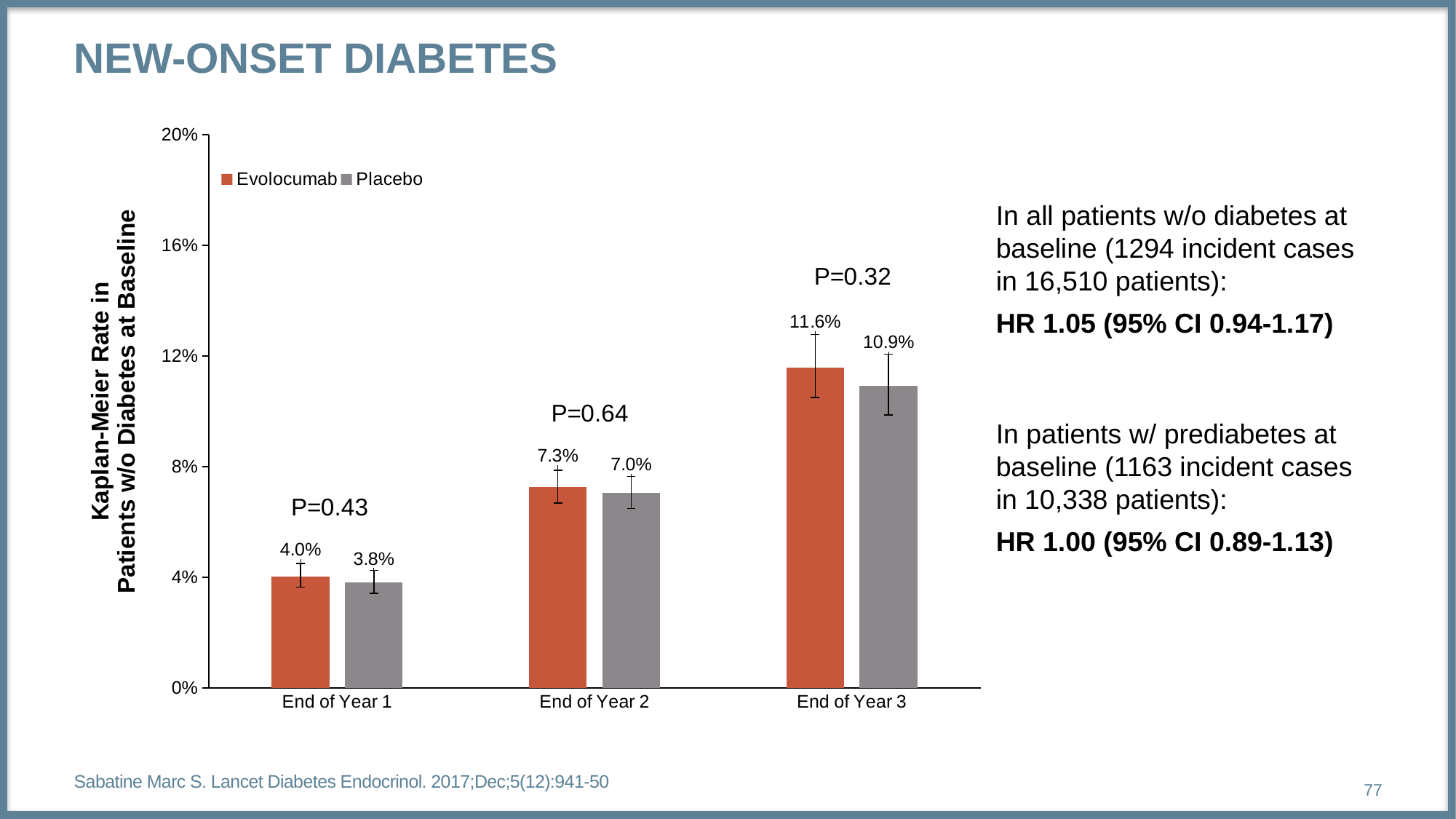
At which time point is the Evolocumab rate highest? End of Year 3 Is the Evolocumab rate at End of Year 3 greater or less than 8%? greater Do the Placebo rates rise or fall from End of Year 1 to End of Year 3? Rise What is the Kaplan-Meier rate for Placebo at End of Year 2? 7.0% How many series does the legend list? 2 What is the Kaplan-Meier rate for Placebo at End of Year 3? 10.9% At which time point is the Placebo rate lowest? End of Year 1 What kind of chart is shown on the slide? Bar chart Which is larger at End of Year 2, the Evolocumab rate or the Placebo rate? Evolocumab What is the Kaplan-Meier rate for Evolocumab at End of Year 1? 4.0% How many time points are shown on the x axis? 3 What is the difference between the Evolocumab and Placebo rates at End of Year 3? 0.7%